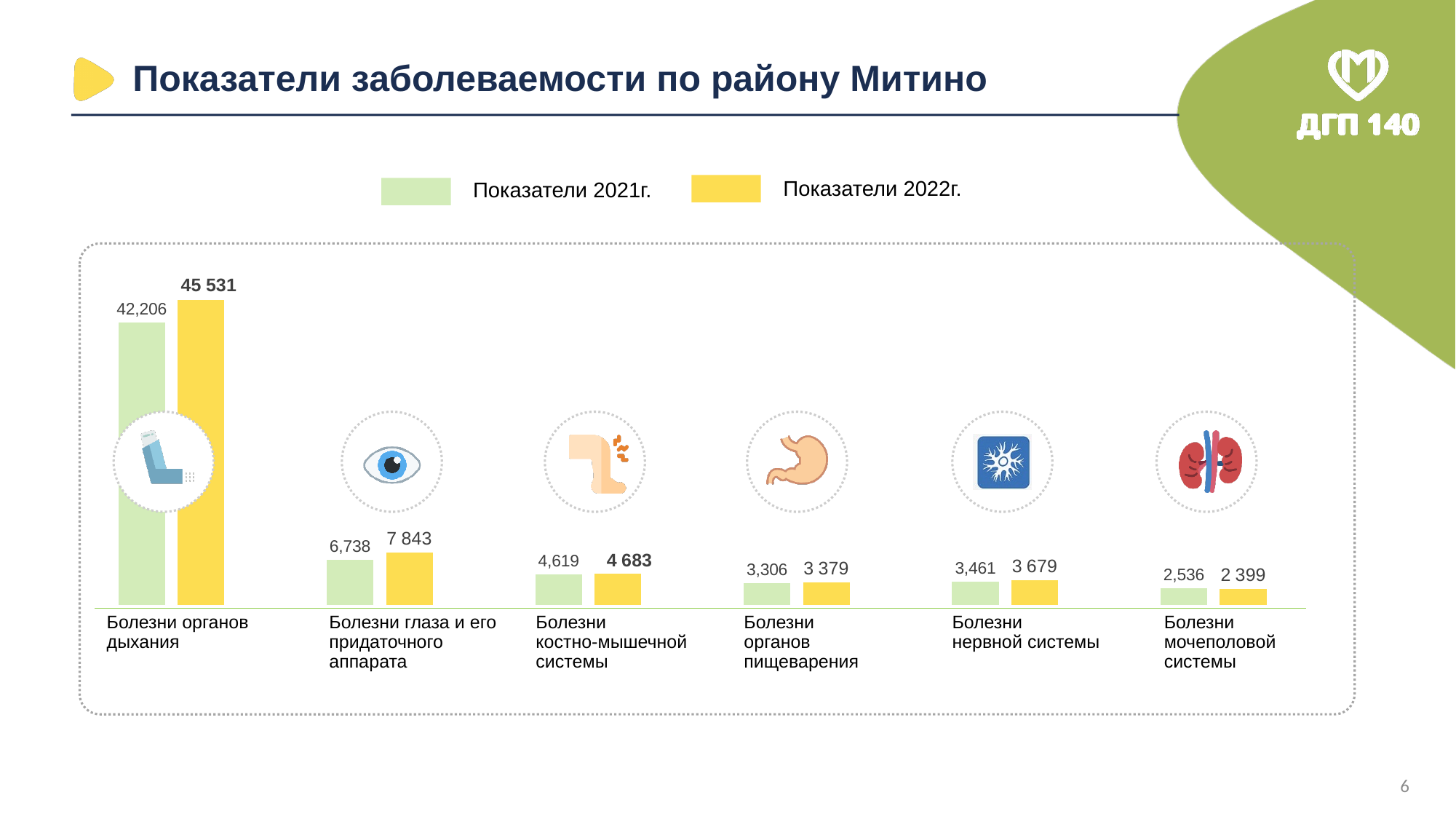
Which category has the highest 2022 value? Болезни органов дыхания What is the 2021 value for Болезни мочеполовой системы? 2,536 For Болезни мочеполовой системы, which is larger: the 2021 value or the 2022 value? 2021 value What kind of chart is shown on the slide? Bar chart Which category has the lowest 2021 value? Болезни мочеполовой системы What is the difference between the 2022 and 2021 values for Болезни глаза и его придаточного аппарата? 1,105 How many disease categories are shown on the chart? 6 What is the 2022 value (Показатели 2022г.) for Болезни органов дыхания? 45 531 How many series does the legend list? 2 What is the difference between the 2022 and 2021 values for Болезни органов дыхания? 3,325 What is the 2022 value for Болезни глаза и его придаточного аппарата? 7 843 What is the 2021 value (Показатели 2021г.) for Болезни органов дыхания? 42,206